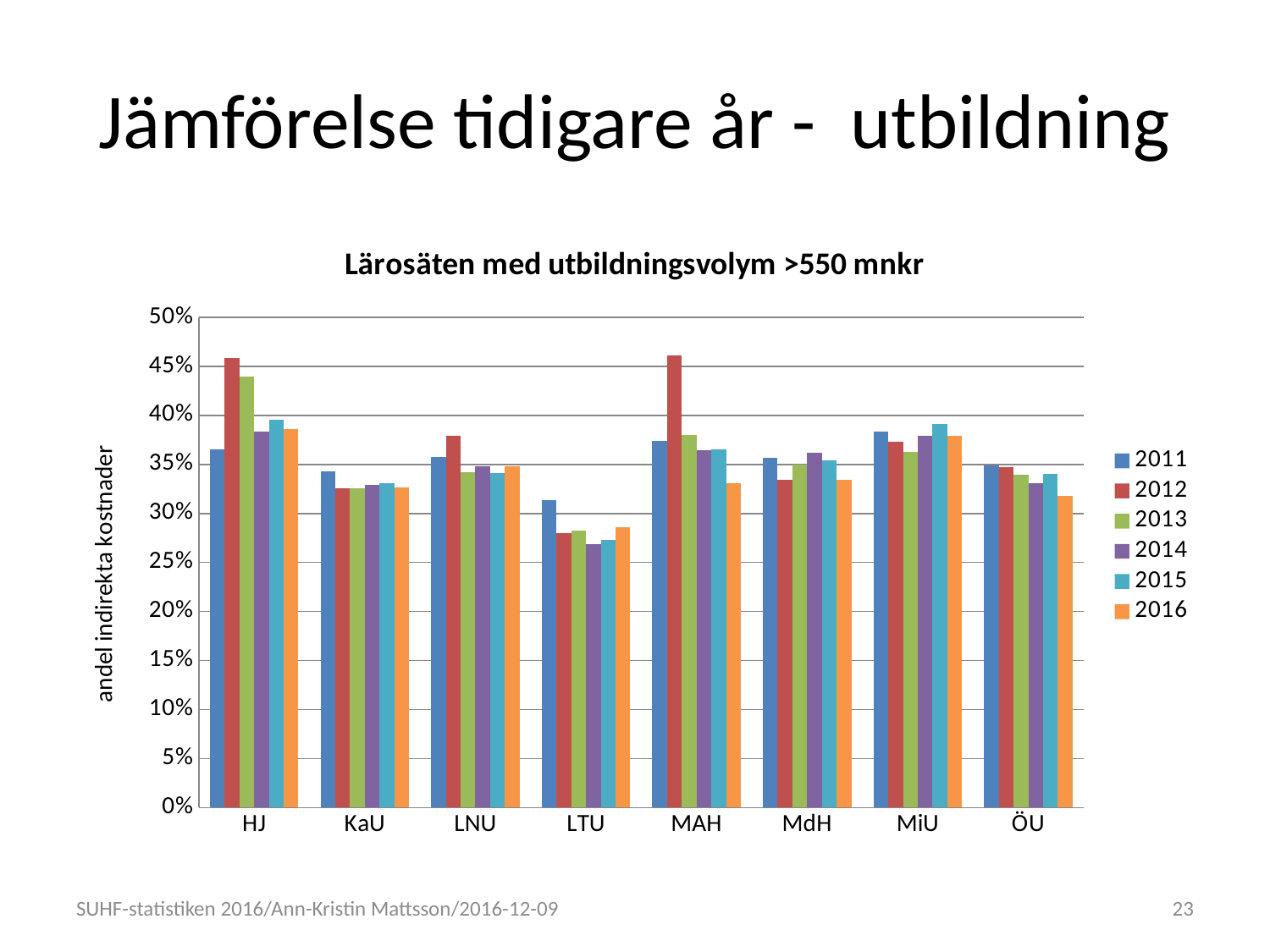
How many series does the legend list? 6 What is the title of the chart? Lärosäten med utbildningsvolym >550 mnkr What is the label on the vertical axis of the chart? andel indirekta kostnader For MAH, which is larger: the 2012 value or the 2016 value? 2012 Which institution has the lowest 2016 value? LTU Is the 2015 value for MiU greater or less than 35%? greater How many institutions (categories) are shown on the x axis of the chart? 8 Is the 2012 value for HJ greater or less than 45%? greater For HJ, which year has the highest value? 2012 What kind of chart is shown on the slide? bar chart Is the 2014 value for LTU greater or less than 30%? less